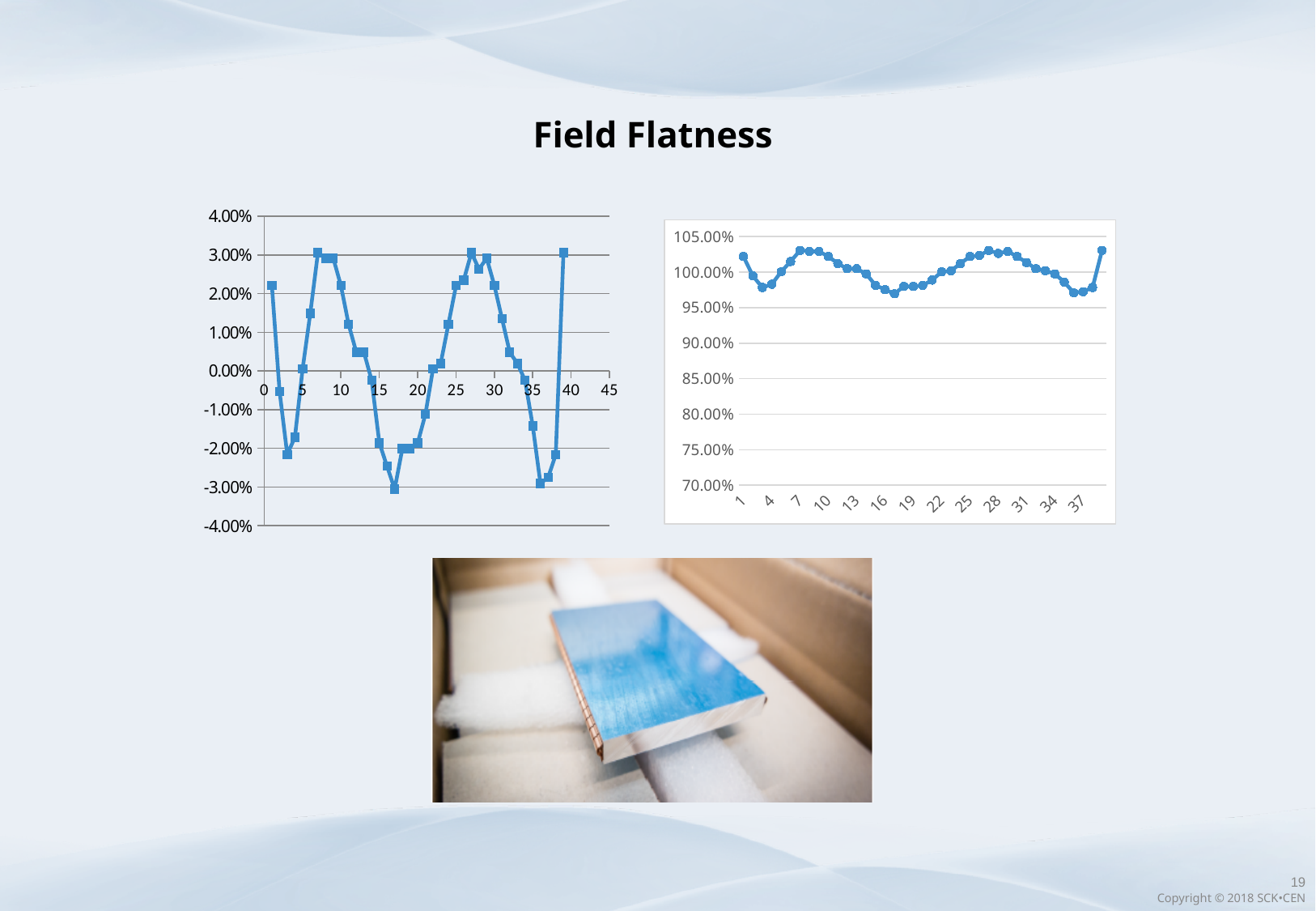
In the left chart, is the value at x = 35 greater or less than -2.00%? greater What kind of chart is the chart on the left of the slide? line chart In the left chart, is the value at x = 1 greater or less than 2.00%? greater In the right chart, is the value at category 28 greater or less than 100.00%? greater In the left chart, which is larger: the value at x = 1 or the value at x = 3? x = 1 What kind of chart is the chart on the right of the slide? line chart What is the highest value shown on the vertical axis of the right chart? 105.00% In the right chart, does the line rise or fall between category 4 and category 7? rise In the right chart, which is larger: the value at category 7 or the value at category 16? category 7